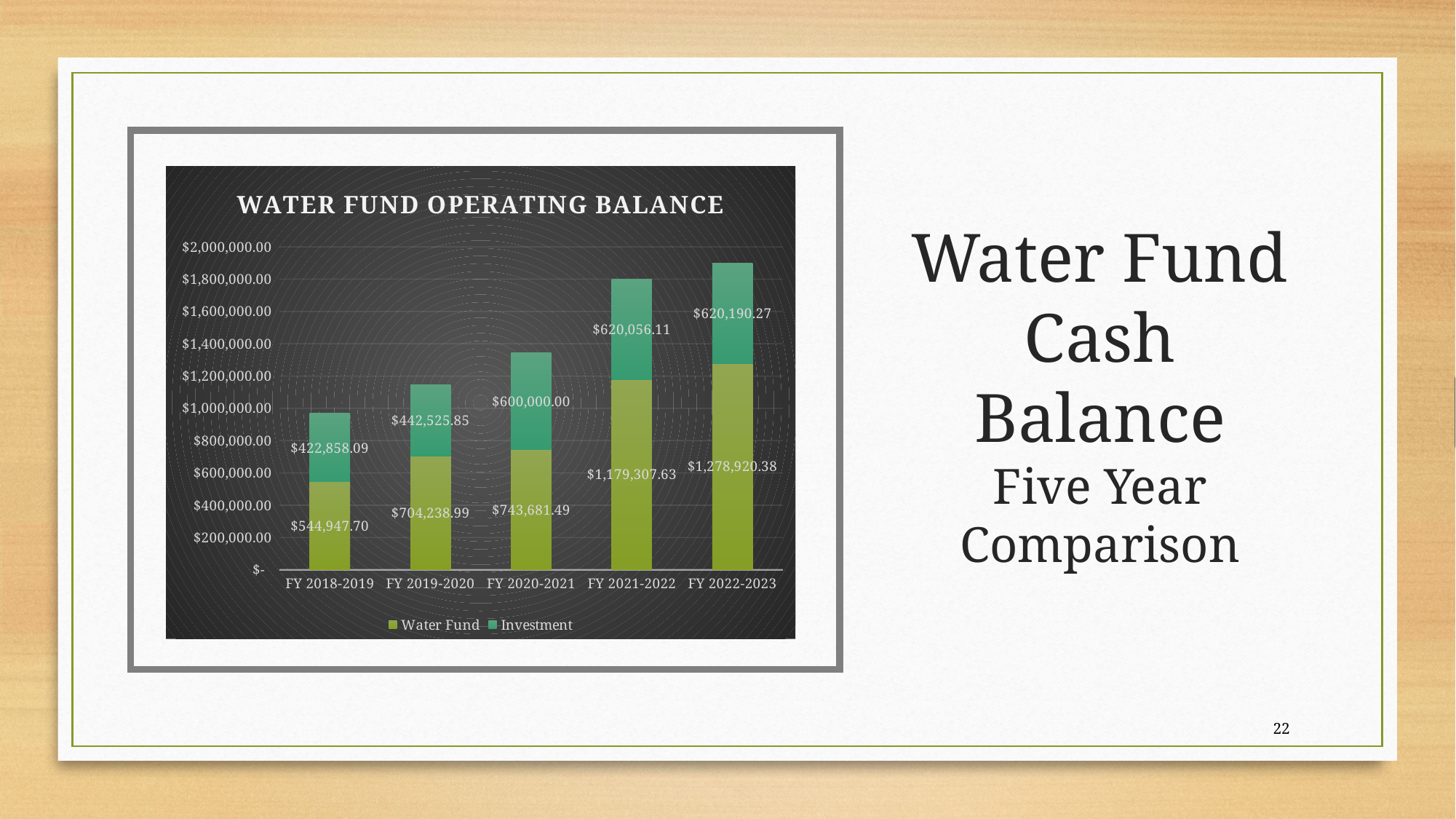
How many series does the legend list? 2 What is the Water Fund value for FY 2022-2023? $1,278,920.38 Which is larger, the Water Fund value for FY 2019-2020 or for FY 2020-2021? FY 2020-2021 Which fiscal year has the lowest Investment value? FY 2018-2019 What is the total of the stacked bar for FY 2018-2019? $967,805.79 What is the difference between the Water Fund values for FY 2022-2023 and FY 2021-2022? $99,612.75 Which fiscal year has the highest Water Fund value? FY 2022-2023 What is the Investment value for FY 2020-2021? $600,000.00 What is the Water Fund value for FY 2018-2019? $544,947.70 What kind of chart is shown? stacked bar chart How many fiscal years are shown on the x axis? 5 Is the total stacked bar for FY 2021-2022 greater or less than $1,600,000.00? greater